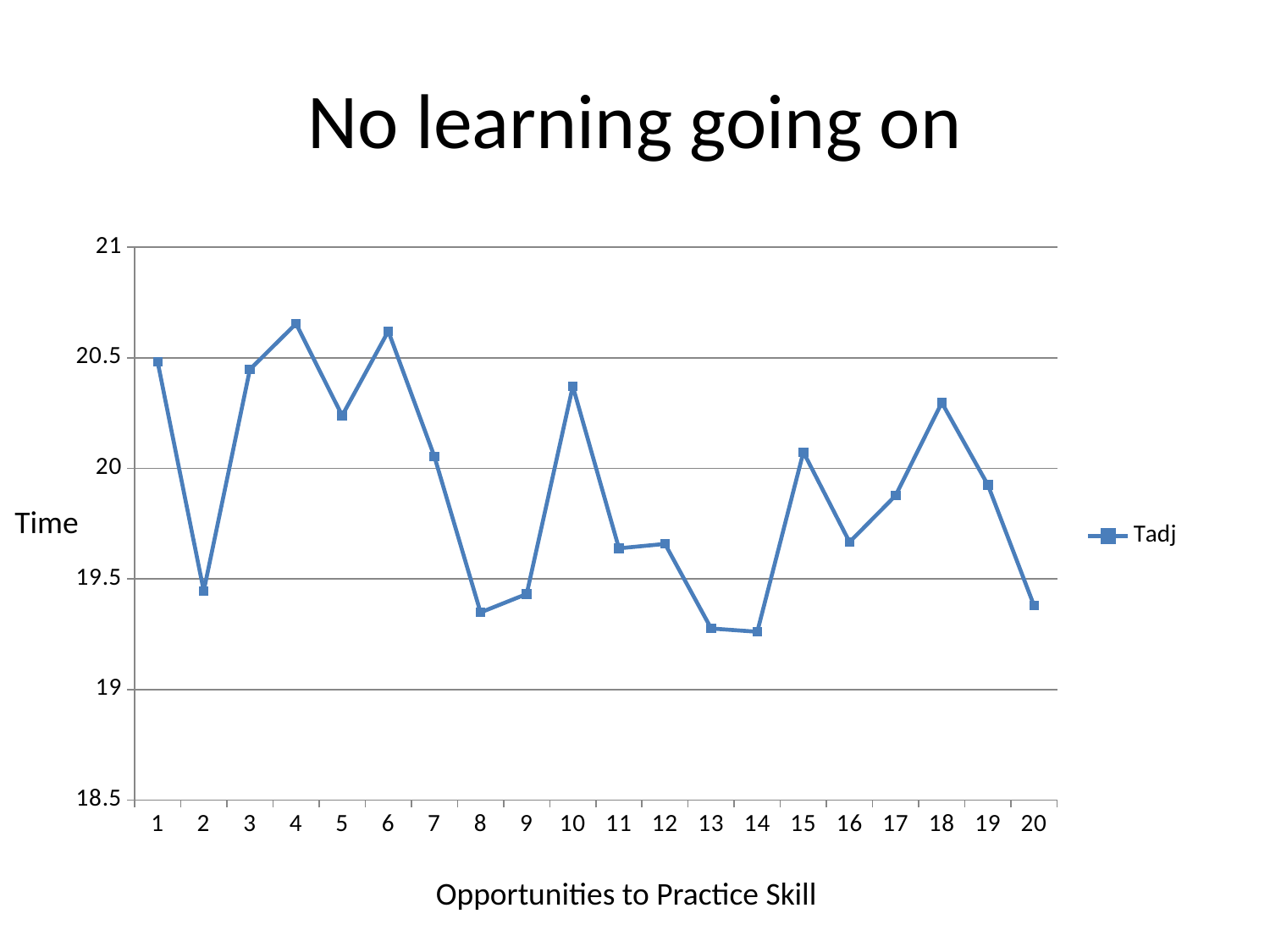
Is the value for opportunity 18 greater or less than 20? greater How many series does the legend list? 1 Which has the larger value, opportunity 4 or opportunity 2? opportunity 4 Is the value for opportunity 8 greater or less than 19.5? less What is the title of the chart? No learning going on How many data points are plotted along the x axis? 20 Is the value for opportunity 13 greater or less than 19.5? less What kind of chart is shown on the slide? line chart What is the label on the x axis? Opportunities to Practice Skill Which has the larger value, opportunity 18 or opportunity 20? opportunity 18